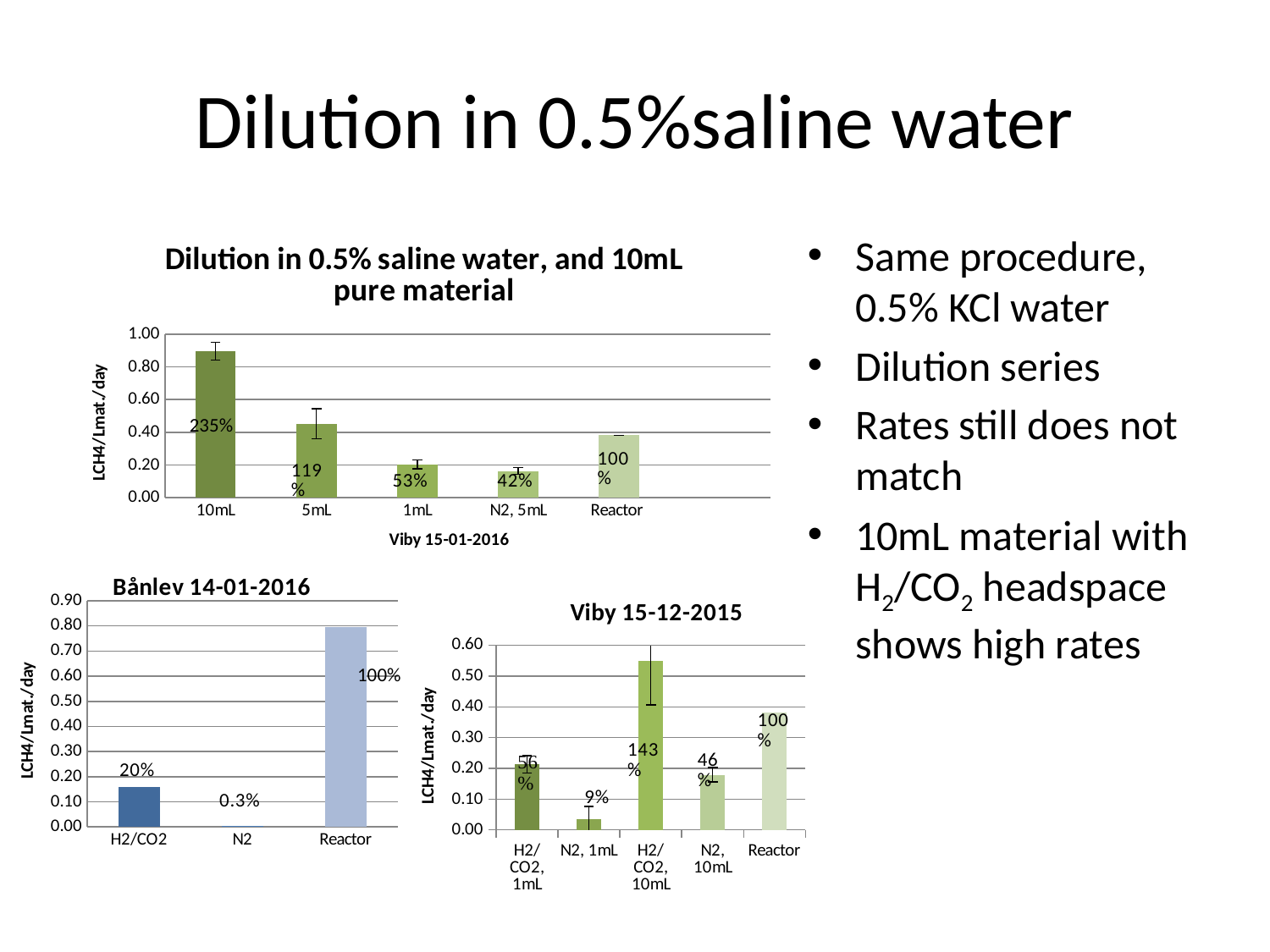
In the 'Dilution in 0.5% saline water, and 10mL pure material' chart, which category has the tallest bar? 10mL In the 'Bånlev 14-01-2016' chart, is the value for H2/CO2 greater or less than 0.20? less In the 'Dilution in 0.5% saline water, and 10mL pure material' chart, what percentage label is shown on the 10mL bar? 235% What type of chart is 'Bånlev 14-01-2016'? Bar chart In the 'Viby 15-12-2015' chart, what percentage label is shown on the 'H2/CO2, 10mL' bar? 143% In the 'Viby 15-12-2015' chart, which category has the lowest value? N2, 1mL In the 'Dilution in 0.5% saline water, and 10mL pure material' chart, is the value for 10mL greater or less than 0.80? greater In the 'Bånlev 14-01-2016' chart, which category has the highest value? Reactor What is the y-axis label of the 'Viby 15-12-2015' chart? LCH4/Lmat./day In the 'Bånlev 14-01-2016' chart, what percentage label is shown on the N2 bar? 0.3% How many categories are shown on the x axis of the 'Dilution in 0.5% saline water, and 10mL pure material' chart? 5 In the 'Viby 15-12-2015' chart, which is larger, the value for 'H2/CO2, 10mL' or the value for Reactor? H2/CO2, 10mL